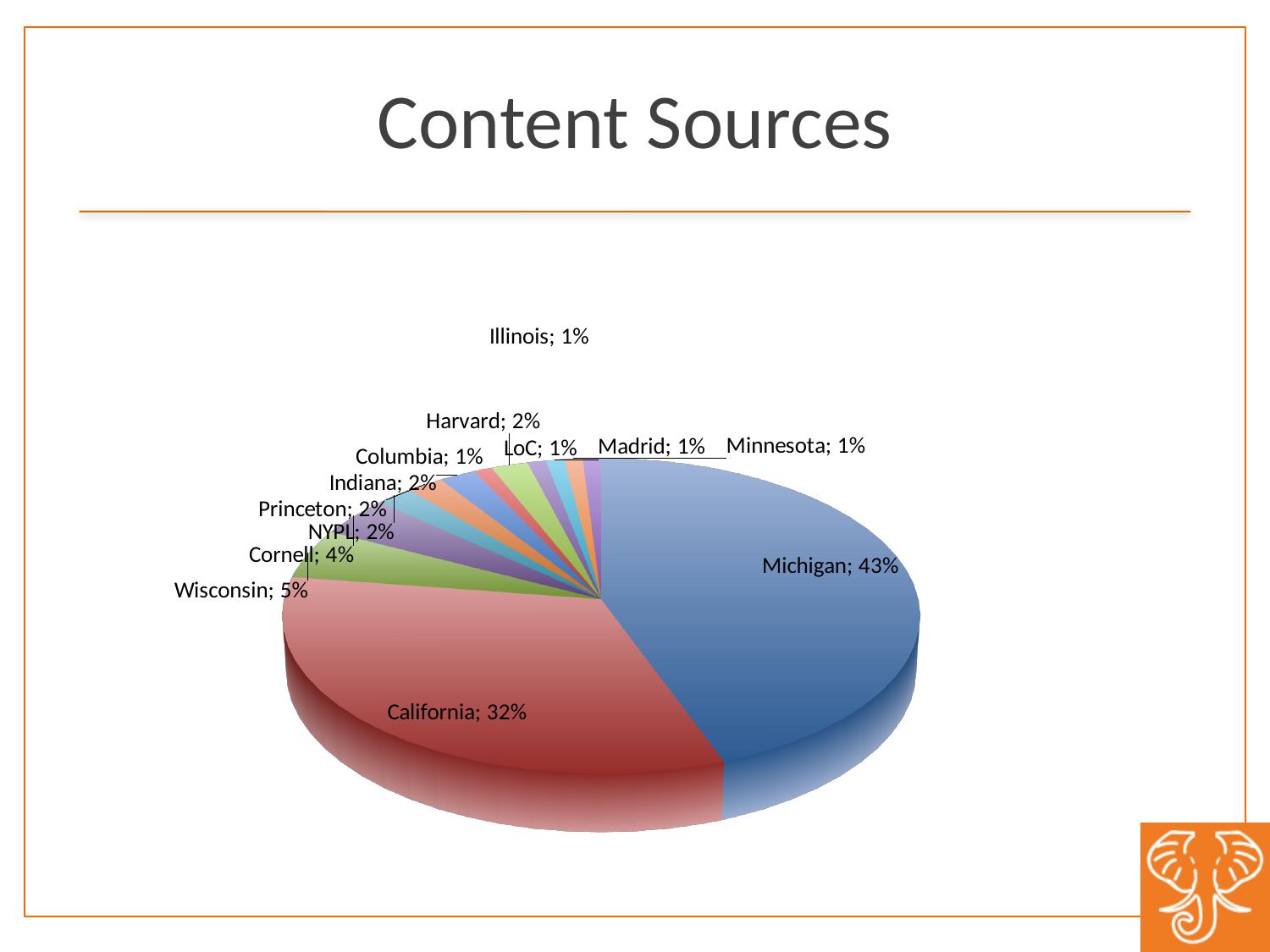
Which content source has the largest slice? Michigan What kind of chart is shown on the slide? Pie chart What share of the pie does Michigan have? 43% What is the difference between the Michigan and California shares? 11% What is the value for Harvard? 2% What share of the pie does California have? 32% What is the value for Cornell? 4% What is the title of the chart? Content Sources How many content sources are shown in the pie chart? 13 Which is larger, the share for Wisconsin or the share for Cornell? Wisconsin What is the value for Wisconsin? 5% What is the combined share of Michigan and California? 75%